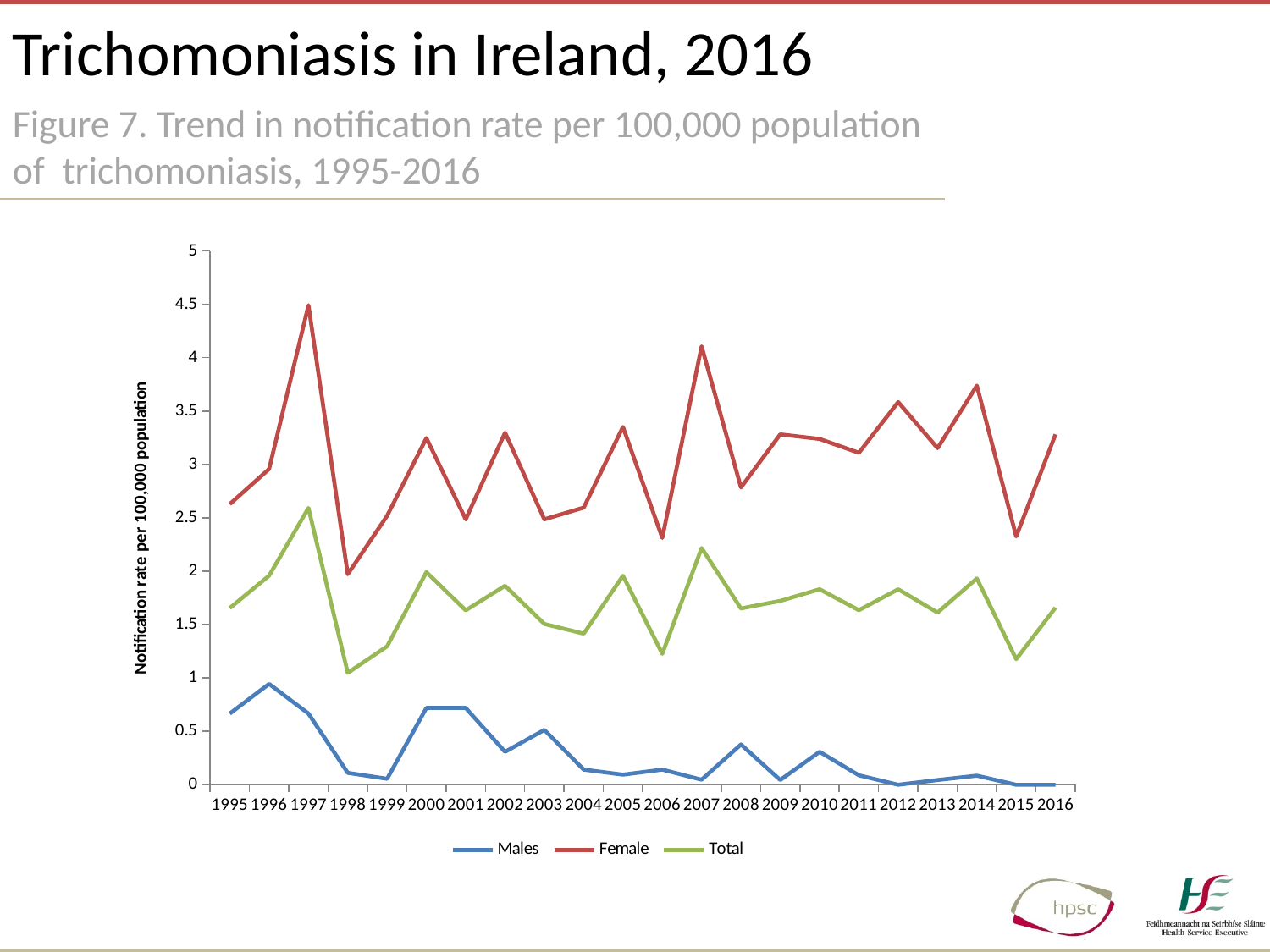
What kind of chart is shown on the slide? line chart Is the Males value for 2000 greater or less than 0.5? greater How many series does the legend list? 3 Is the Female value for 1997 greater or less than 4? greater Is the Total value for 1998 greater or less than 1.5? less In which year is the Males notification rate highest? 1996 Which is larger, the Total value for 2005 or the Total value for 2006? 2005 In which year is the Female notification rate lowest? 1998 How many years are plotted along the x axis? 22 In which year is the Female notification rate highest? 1997 What is the label on the vertical axis? Notification rate per 100,000 population In which year is the Total notification rate highest? 1997